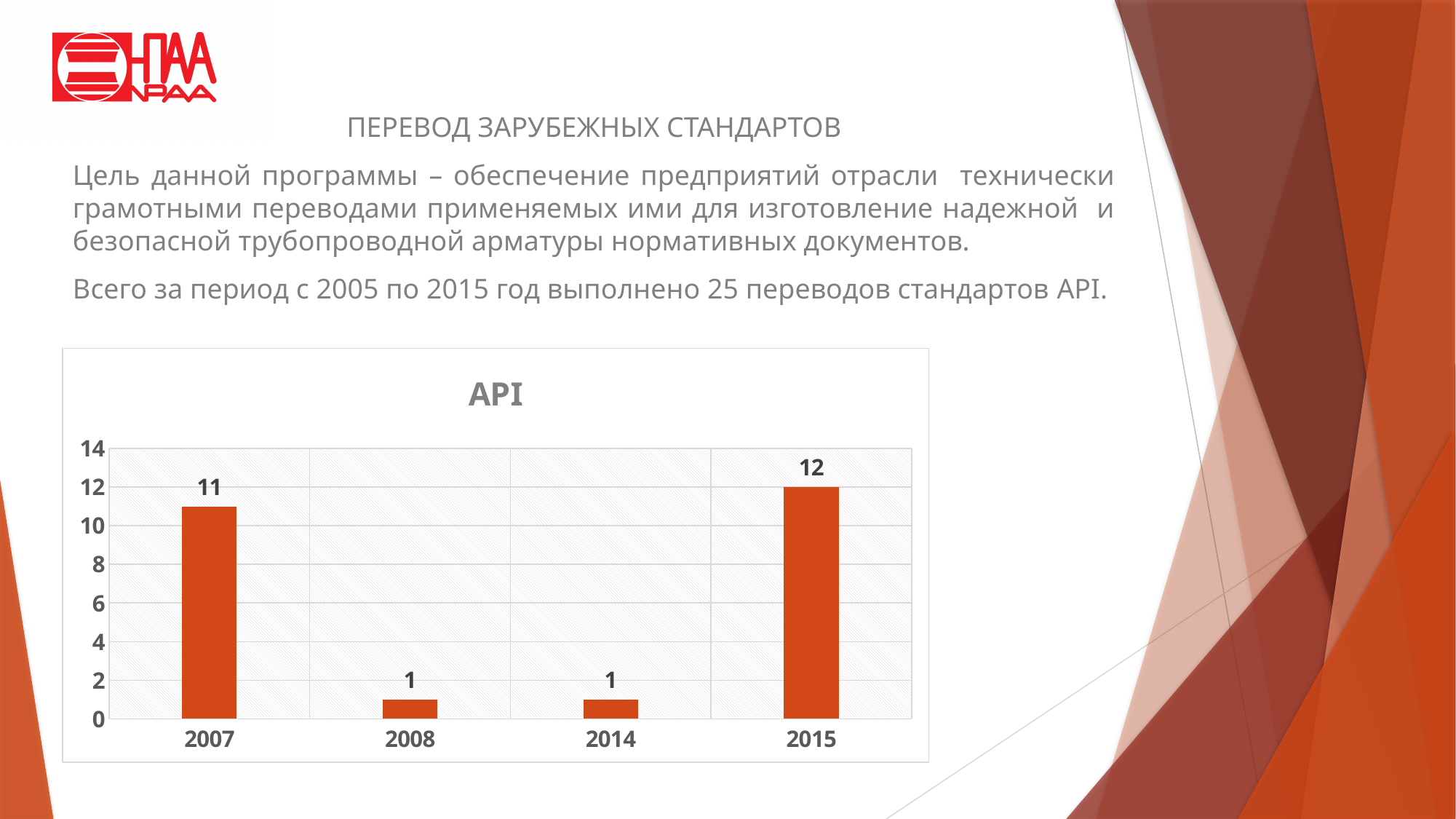
What is the value for 2008 in the API chart? 1 What is the highest value shown on the y axis of the API chart? 14 What is the value for 2007 in the API chart? 11 What is the value for 2015 in the API chart? 12 Is the value for 2015 in the API chart greater or less than 10? greater What is the title of the chart on the slide? API Which year has the highest value in the API chart? 2015 What is the difference between the values for 2007 and 2008 in the API chart? 10 What kind of chart is shown on the slide? bar chart How many years are shown on the x axis of the API chart? 4 What is the difference between the values for 2015 and 2007 in the API chart? 1 Which is larger in the API chart, the value for 2007 or the value for 2014? 2007